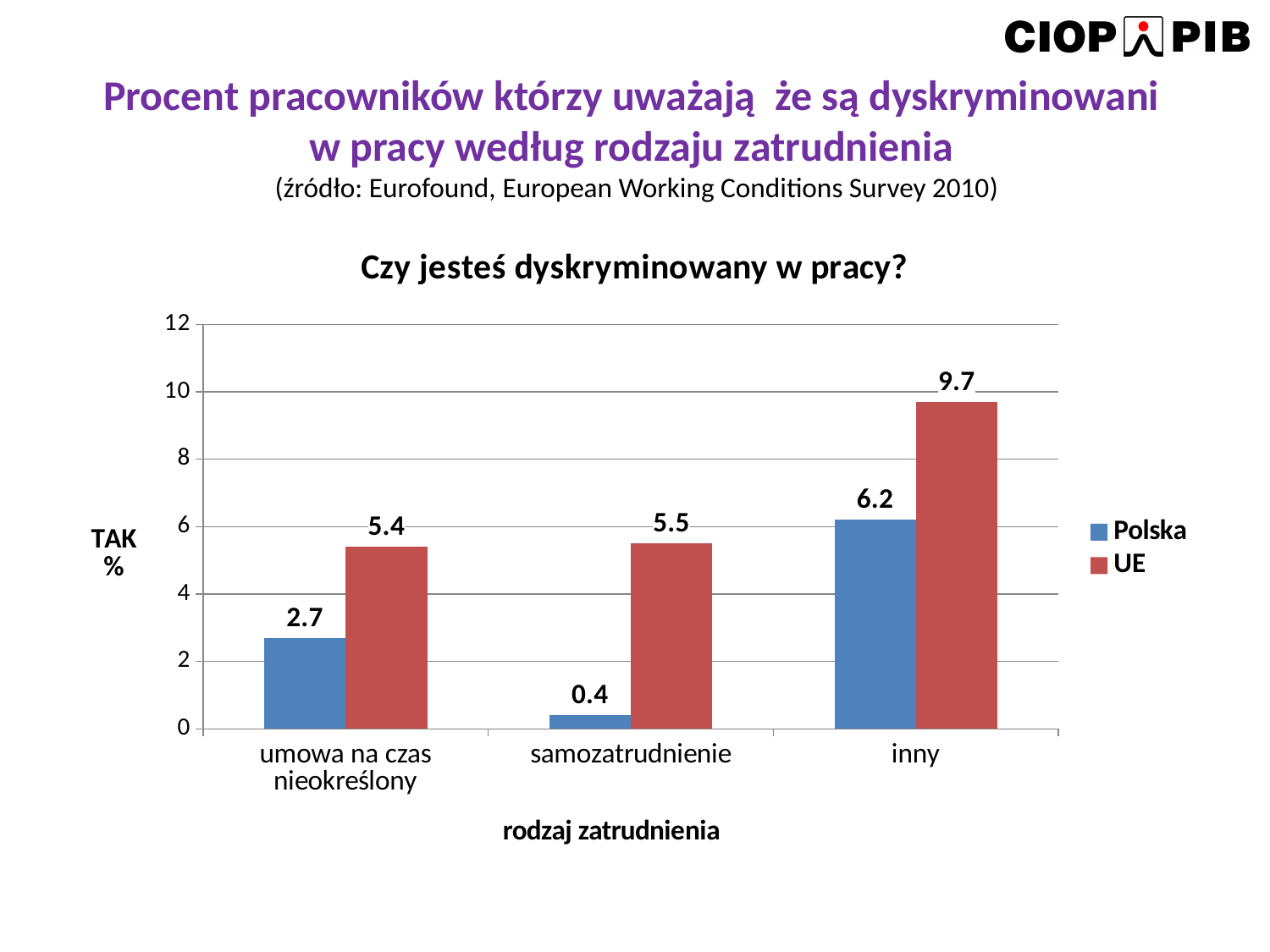
What is the value for Polska in the 'samozatrudnienie' category? 0.4 What is the title of the chart? Czy jesteś dyskryminowany w pracy? What is the value for UE in the 'samozatrudnienie' category? 5.5 Which category has the highest value for the UE series? inny How many series does the legend list? 2 What is the value for UE in the 'inny' category? 9.7 What is the value for Polska in the 'umowa na czas nieokreślony' category? 2.7 What is the difference between the UE and Polska values in the 'inny' category? 3.5 Which is larger in the 'umowa na czas nieokreślony' category, Polska or UE? UE How many categories are shown on the x axis? 3 What kind of chart is shown on the slide? bar chart Which category has the lowest value for the Polska series? samozatrudnienie